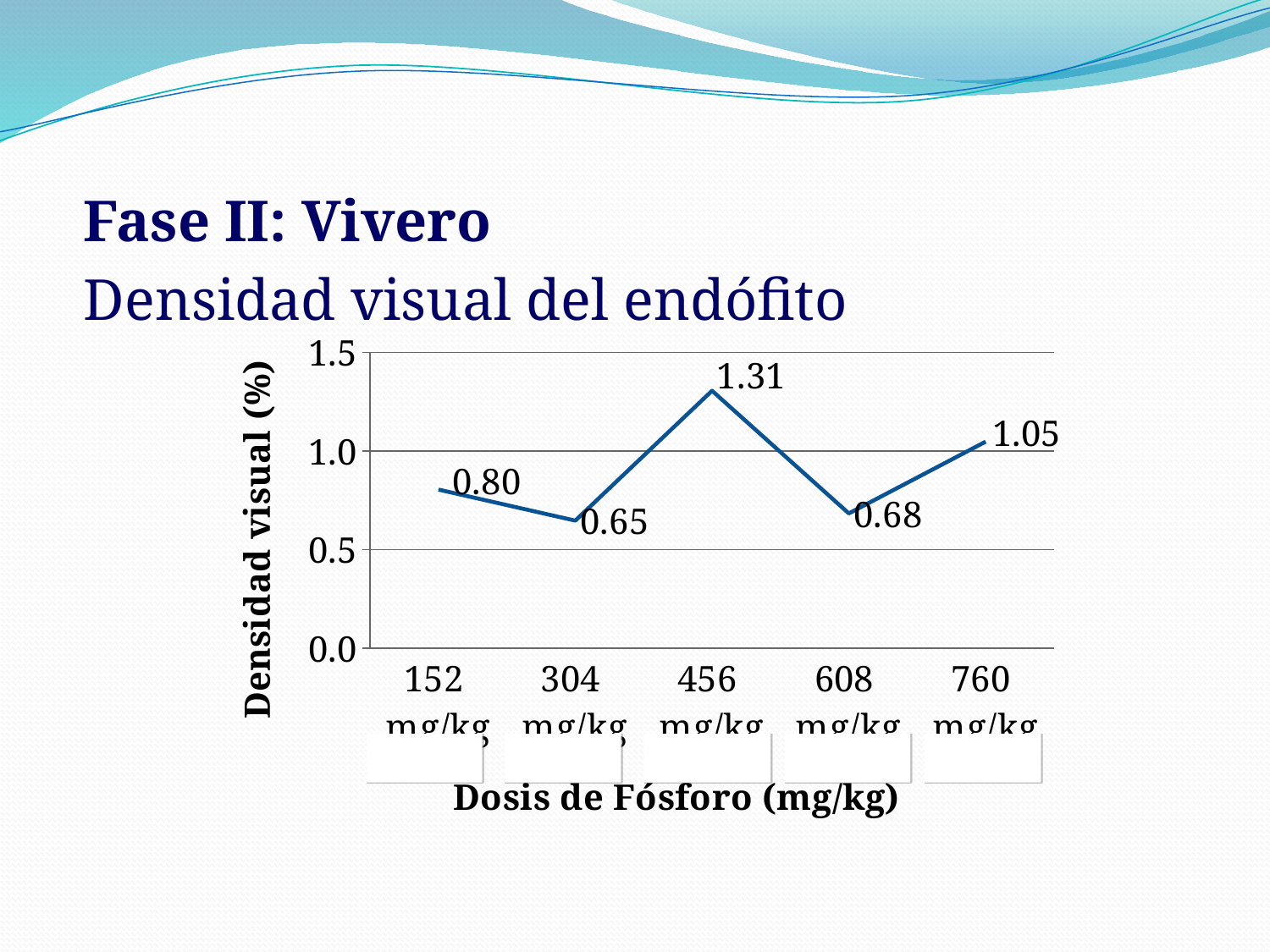
What is the difference in visual density between the 456 mg/kg and 304 mg/kg doses? 0.66 What is the visual density value for the 456 mg/kg phosphorus dose? 1.31 Which phosphorus dose has the highest visual density? 456 mg/kg What is the label of the vertical axis of the chart? Densidad visual (%) What is the visual density value for the 152 mg/kg phosphorus dose? 0.80 Is the visual density for the 760 mg/kg dose greater or less than 1.0? greater What is the difference in visual density between the 760 mg/kg and 608 mg/kg doses? 0.37 Which has a higher visual density, the 152 mg/kg dose or the 608 mg/kg dose? 152 mg/kg What kind of chart is shown on the slide? line chart How many phosphorus doses are plotted on the chart? 5 Which phosphorus dose has the lowest visual density? 304 mg/kg What is the visual density value for the 760 mg/kg phosphorus dose? 1.05